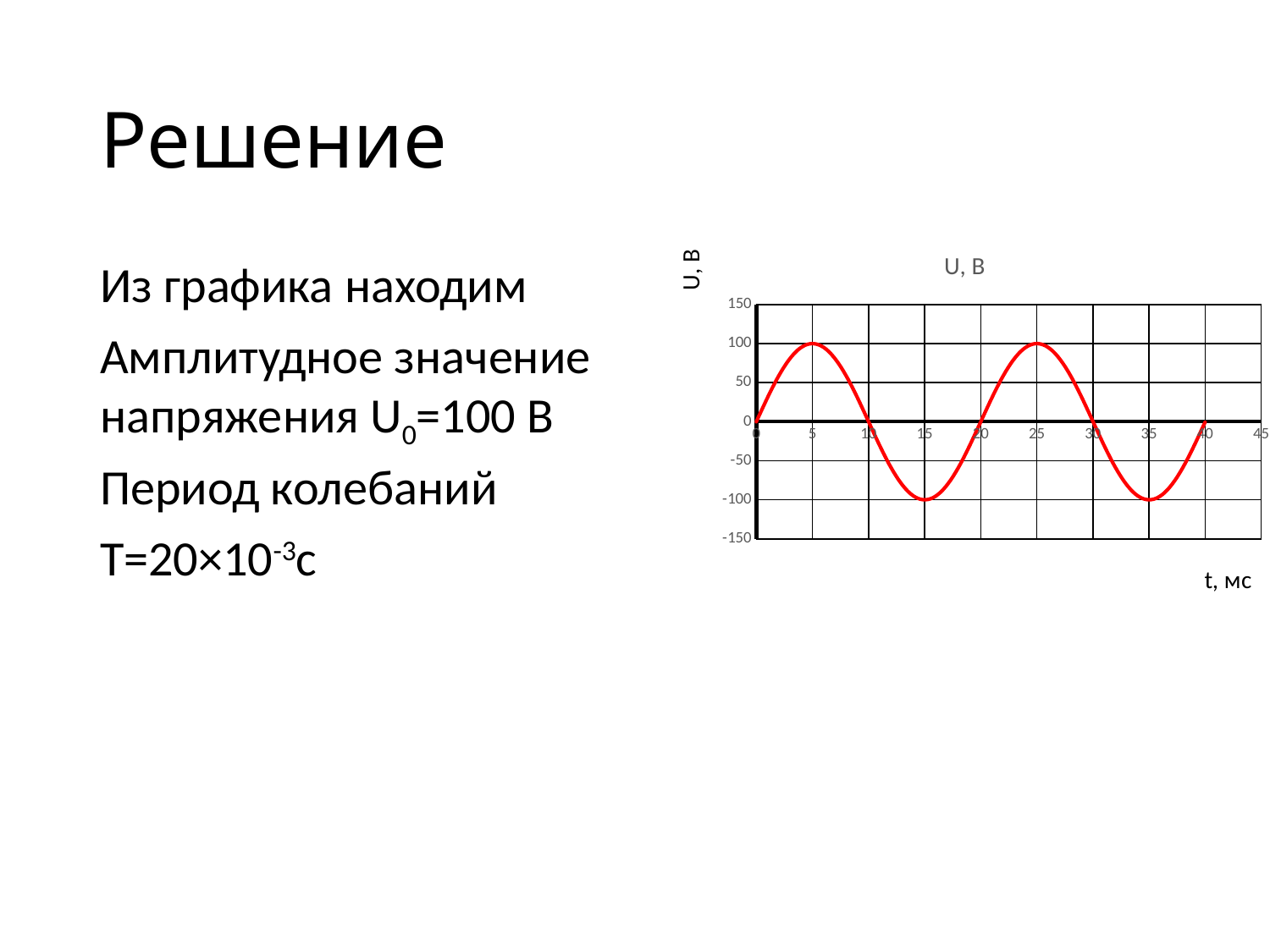
Is the value of U at t = 25 мс greater or less than 50? greater What is the value of U at t = 5 мс on the chart? 100 What is the title of the chart? U, B What is the value of U at t = 20 мс on the chart? 0 What is the minimum value of U reached by the curve on the chart? -100 What is the maximum value of U reached by the curve on the chart? 100 Is the value of U at t = 35 мс greater or less than -50? less What is the label of the horizontal axis of the chart? t, мс Which is larger on the chart: the value of U at t = 5 мс or at t = 15 мс? t = 5 мс Does the curve rise or fall between t = 10 мс and t = 15 мс? fall What kind of chart is shown on the slide? line chart What is the value of U at t = 15 мс on the chart? -100